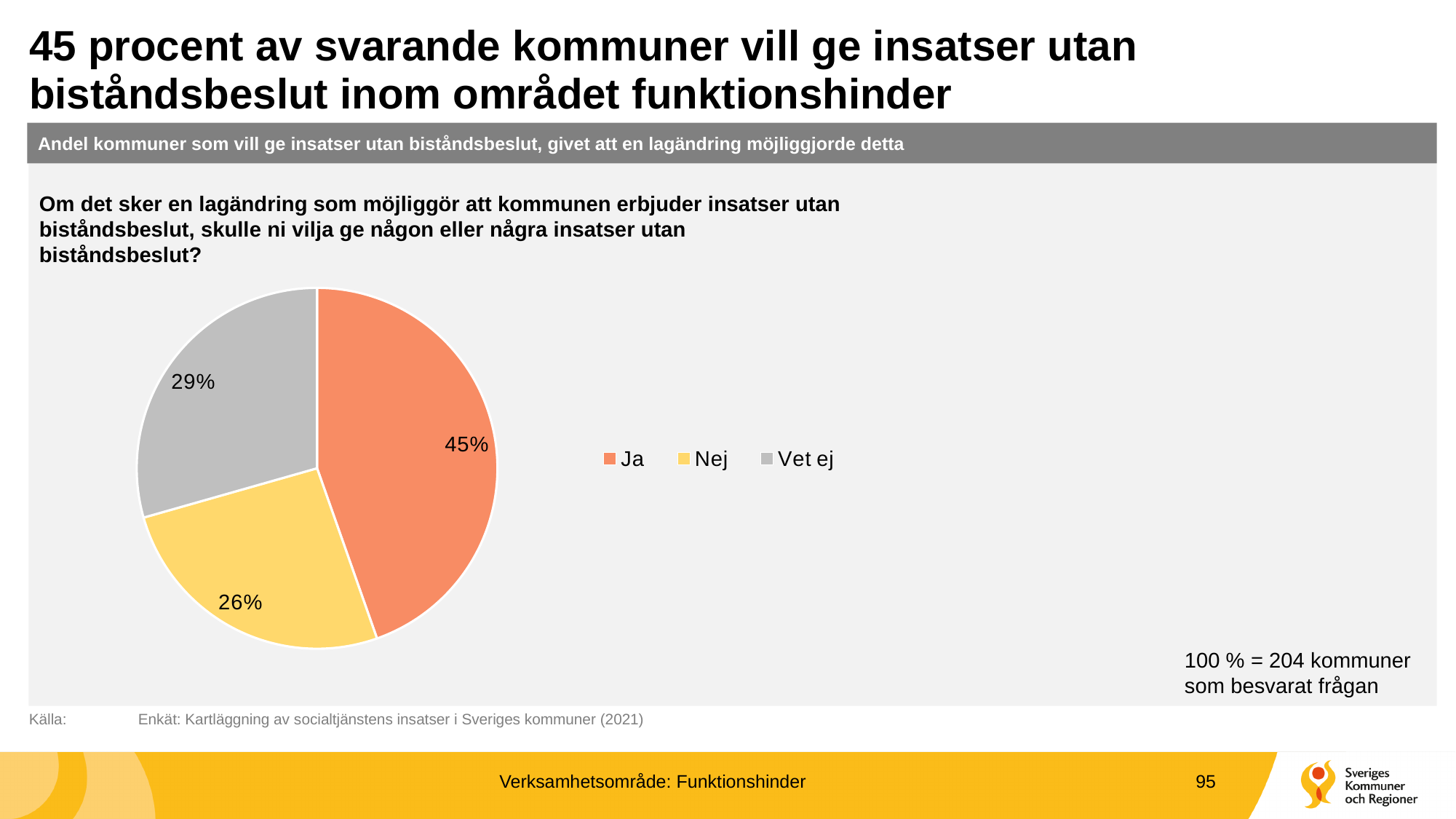
Which category has the smallest slice of the pie? Nej What share of the pie does "Ja" represent? 45% Which category has the largest slice of the pie? Ja What share of the pie does "Nej" represent? 26% What kind of chart is shown on the slide? Pie chart What share of the pie does "Vet ej" represent? 29% Which is larger, the share for "Ja" or the share for "Vet ej"? Ja What colour is the "Vet ej" slice? Grey How many categories does the pie chart have? 3 According to the note on the slide, how many kommuner does 100 % correspond to? 204 kommuner What is the difference in percentage points between "Vet ej" and "Nej"? 3 What is the difference in percentage points between "Ja" and "Nej"? 19